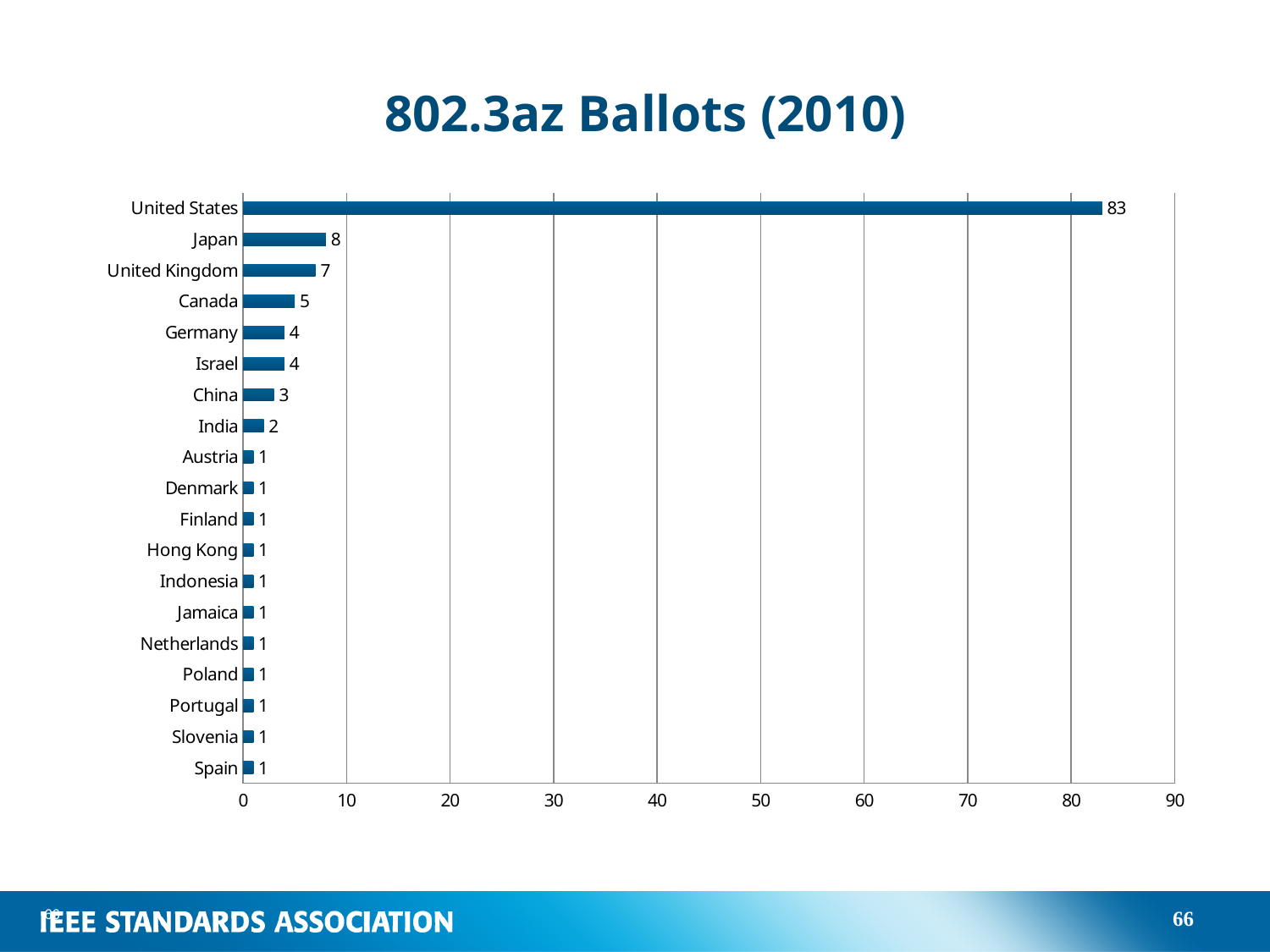
What is the value for Japan? 8 What is the value for Canada? 5 Is the value for the United States greater or less than 80? greater What is the value for the United States? 83 How many countries are shown in the chart? 19 Which is larger, the value for Germany or the value for China? Germany What is the title of the chart? 802.3az Ballots (2010) What is the value for China? 3 What kind of chart is shown on the slide? Bar chart What is the difference between the values for the United States and Japan? 75 Which country has the highest number of ballots? United States What is the difference between the values for the United Kingdom and India? 5